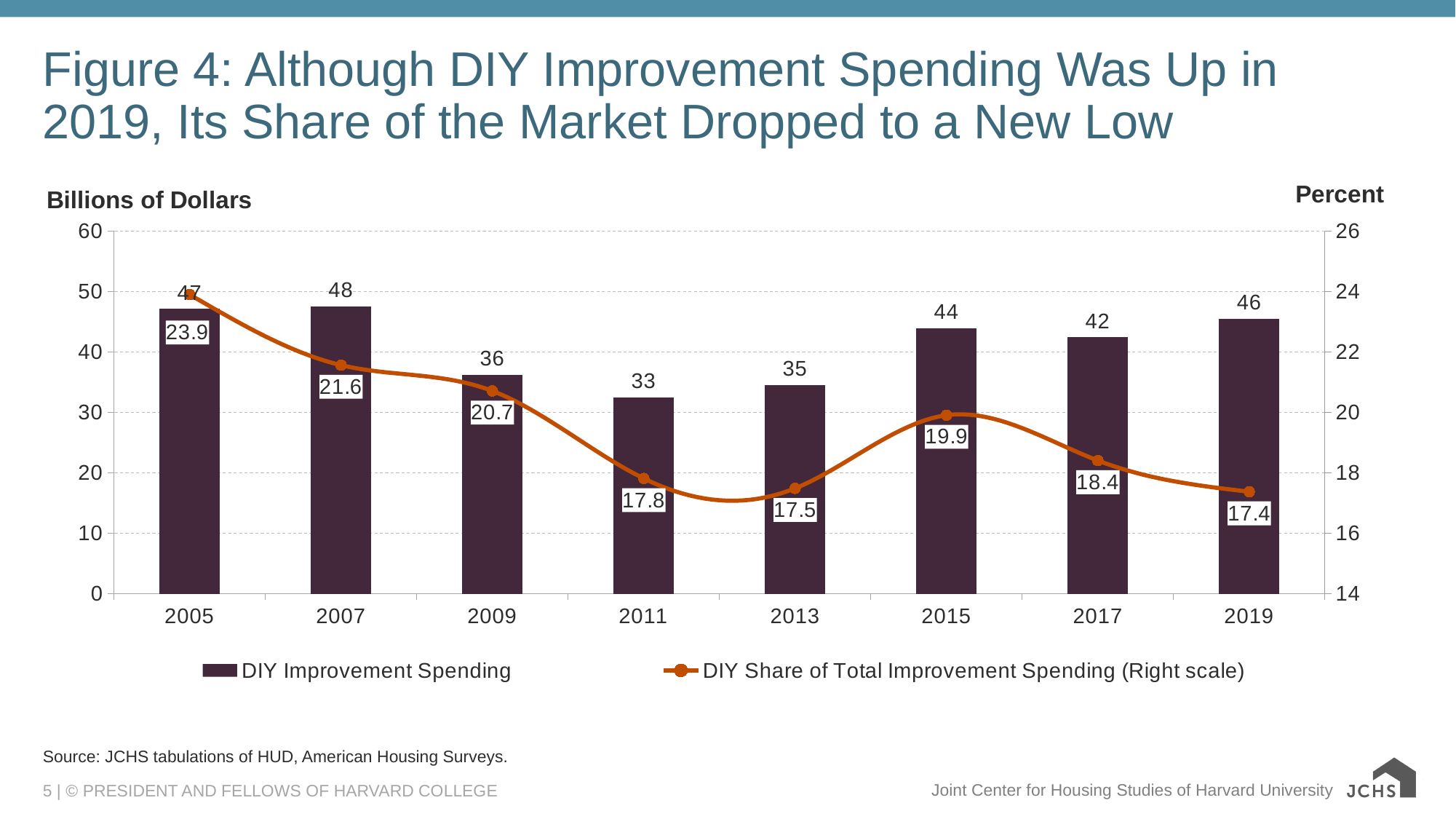
What was the DIY Share of Total Improvement Spending in 2005? 23.9 How many series does the legend list? 2 Which year had the highest DIY Improvement Spending? 2007 By how many percentage points did the DIY Share of Total Improvement Spending fall from 2005 to 2019? 6.5 Was DIY Improvement Spending higher in 2015 or in 2017? 2015 What was DIY Improvement Spending in 2019? 46 What is the difference in DIY Improvement Spending between 2007 and 2011? 15 How many years are shown on the x axis? 8 Which year had the lowest DIY Improvement Spending? 2011 Which year had the lowest DIY Share of Total Improvement Spending? 2019 What was the DIY Share of Total Improvement Spending in 2013? 17.5 What is the label of the right-hand axis? Percent